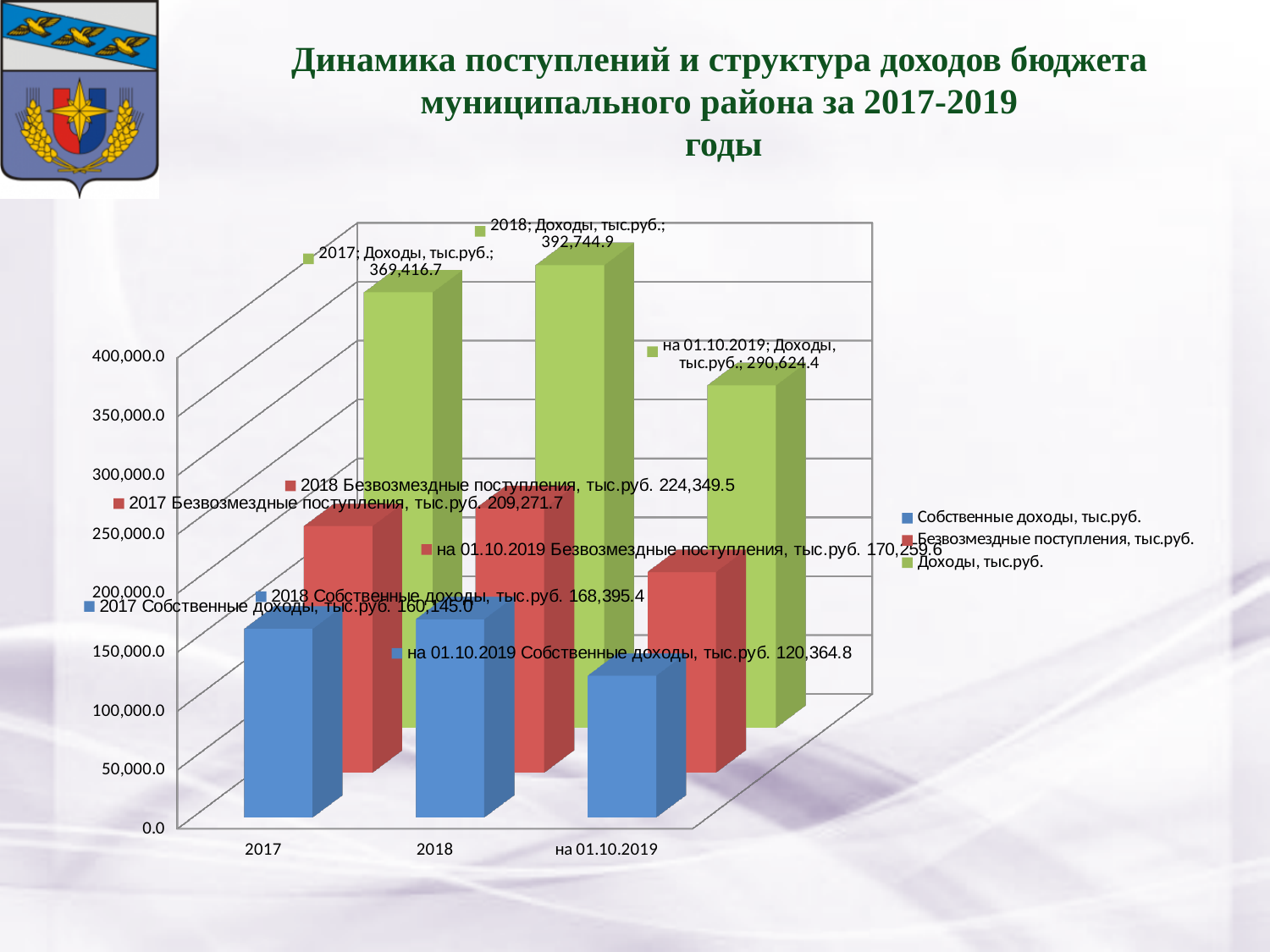
What is the value of Безвозмездные поступления, тыс.руб. for на 01.10.2019? 170,259.6 What is the value of Доходы, тыс.руб. for на 01.10.2019? 290,624.4 Which colour represents Доходы, тыс.руб. in the chart? Green What is the value of Собственные доходы, тыс.руб. for 2017? 160,145.0 How many series does the chart legend list? 3 Which is larger: Безвозмездные поступления, тыс.руб. for 2017 or for 2018? 2018 Which period has the lowest value of Собственные доходы, тыс.руб.? на 01.10.2019 Which period has the highest value of Доходы, тыс.руб.? 2018 How many periods are shown on the x axis of the chart? 3 What is the value of Доходы, тыс.руб. for 2018? 392,744.9 What kind of chart is shown on the slide? Bar chart What is the difference between Доходы, тыс.руб. for 2018 and for 2017? 23,328.2